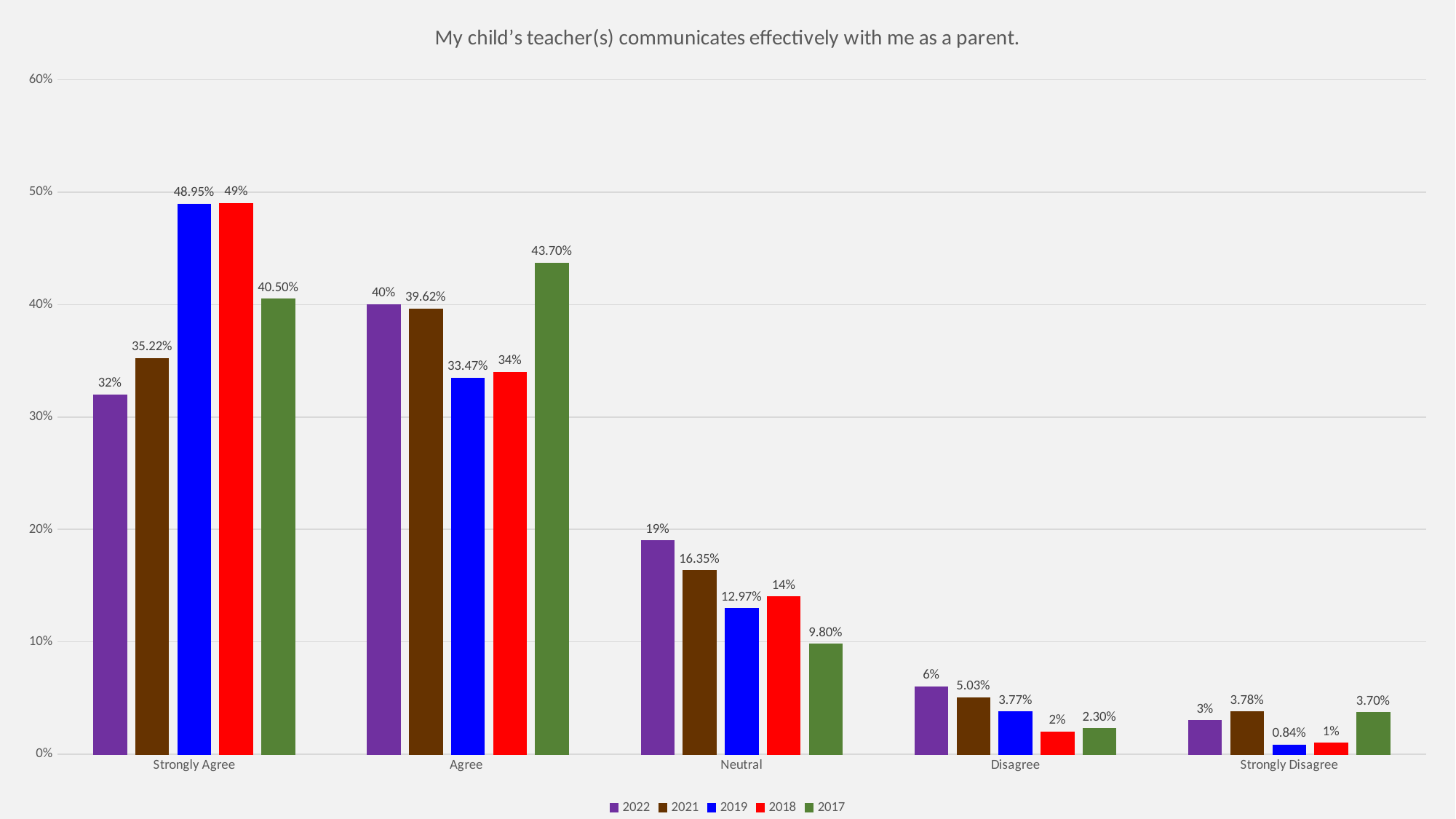
How many series does the legend list? 5 What is the value for 2018 in the Disagree category? 2% What is the title of the chart? My child’s teacher(s) communicates effectively with me as a parent. What is the difference between the 2022 and 2017 values in the Neutral category? 9.20% What is the value for 2019 in the Strongly Agree category? 48.95% Which year has the highest value in the Strongly Agree category? 2018 Which is larger in the Agree category: the value for 2022 or the value for 2019? 2022 Which year has the lowest value in the Strongly Disagree category? 2019 What is the value for 2021 in the Neutral category? 16.35% What kind of chart is shown on the slide? Bar chart How many response categories are shown on the x axis? 5 What is the value for 2017 in the Agree category? 43.70%